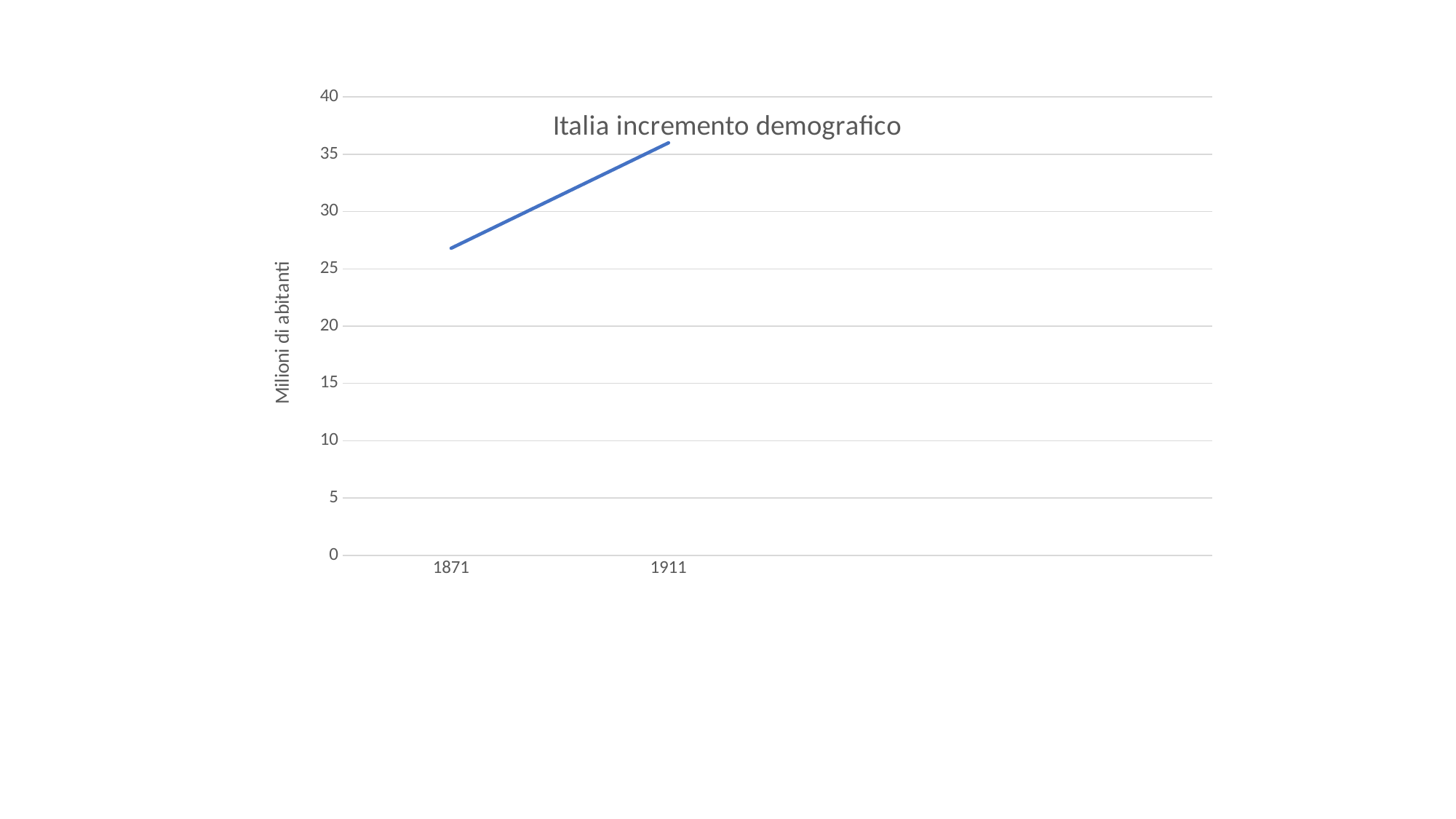
Does the value rise or fall from 1871 to 1911? rise What is the title of the chart? Italia incremento demografico Which year has the higher value, 1871 or 1911? 1911 Is the value for 1911 greater or less than 40? less Is the value for 1871 greater or less than 30? less Is the value for 1871 greater or less than 25? greater Which year has the lowest value on the chart? 1871 How many data points are plotted on the line? 2 What is the label of the vertical axis? Milioni di abitanti Which year has the highest value on the chart? 1911 What kind of chart is shown on the slide? line chart